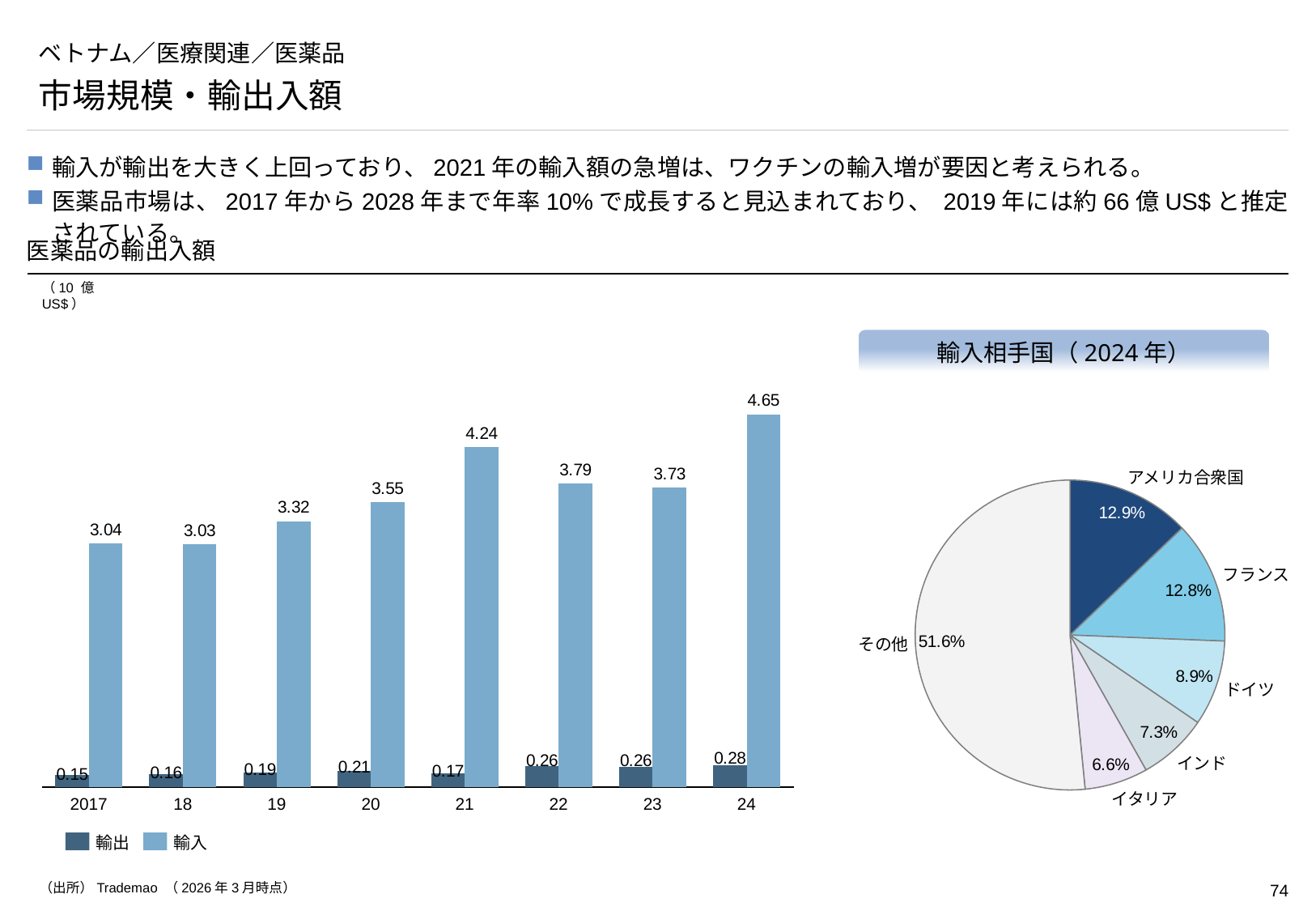
「医薬品の輸出入額」のグラフの凡例には、いくつの系列がありますか？ 2 「医薬品の輸出入額」のグラフで、2024年の輸入と輸出の差はいくらですか？ 4.37 「医薬品の輸出入額」のグラフには、いくつの年が表示されていますか？ 8 「医薬品の輸出入額」のグラフで、2021年の輸入の値はいくらですか？ 4.24 「医薬品の輸出入額」のグラフはどの種類のグラフですか？ 棒グラフ 「医薬品の輸出入額」のグラフで、輸入が最も多い年はどれですか？ 24 「医薬品の輸出入額」のグラフで、2020年の輸出の値はいくらですか？ 0.21 「輸入相手国（2024年）」の円グラフで、ドイツの割合はいくらですか？ 8.9% 「輸入相手国（2024年）」の円グラフで、インドとイタリアの割合の差はいくらですか？ 0.7% 「医薬品の輸出入額」のグラフで、2022年と2023年の輸入ではどちらが大きいですか？ 2022年 「輸入相手国（2024年）」の円グラフで、最も割合が大きい項目はどれですか？ その他 「医薬品の輸出入額」のグラフで、輸出が最も少ない年はどれですか？ 2017